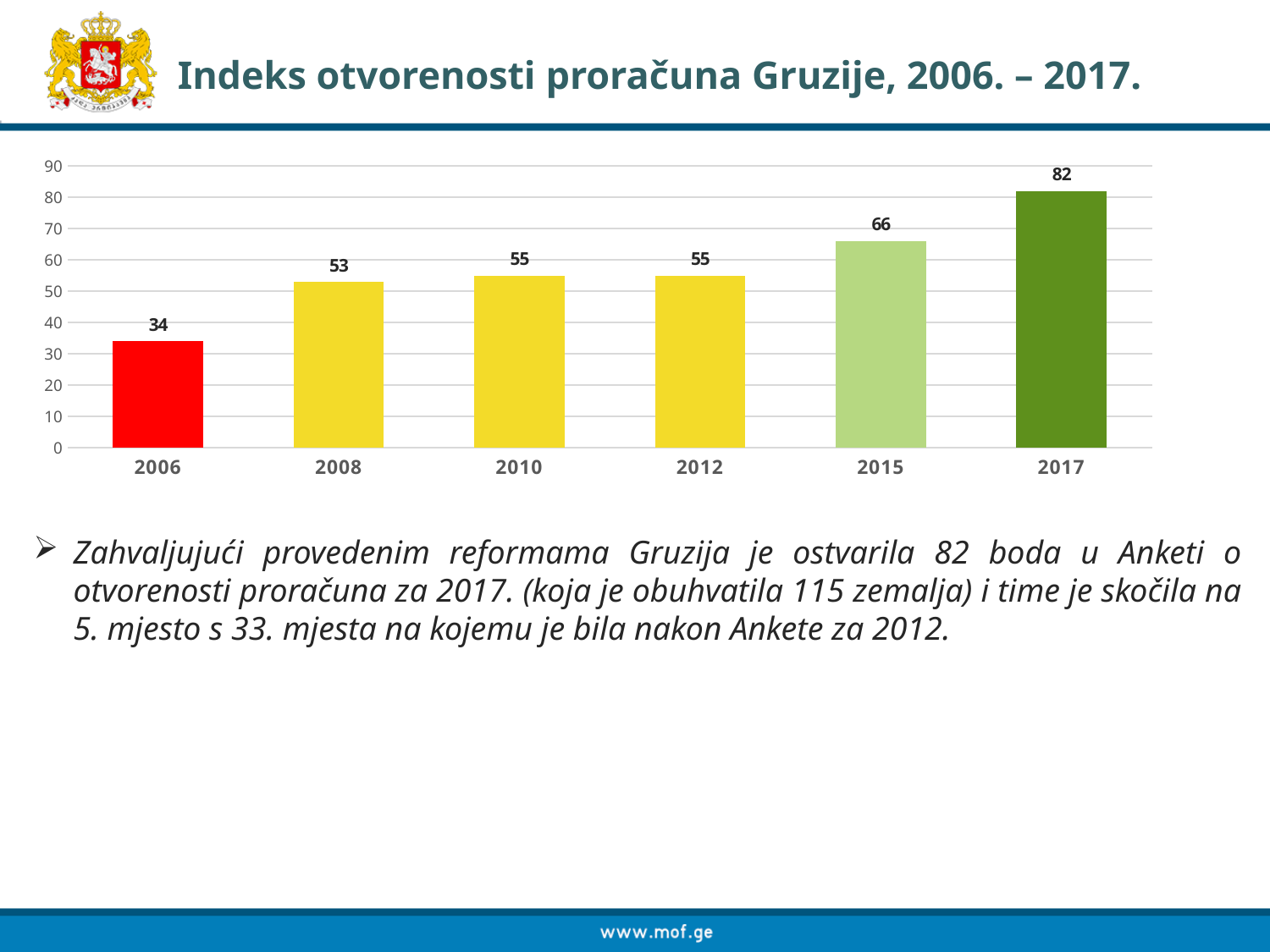
Which is larger, the value for 2008 or the value for 2010? 2010 What is the value for 2015? 66 What colour is the bar for 2006? red What is the value for 2008? 53 What kind of chart is shown on the slide? bar chart What is the difference between the values for 2015 and 2012? 11 Which year has the lowest value? 2006 What is the value for 2006? 34 Is the value for 2017 greater or less than 80? greater Which year has the highest value? 2017 What is the difference between the values for 2017 and 2006? 48 How many years are shown on the x axis? 6